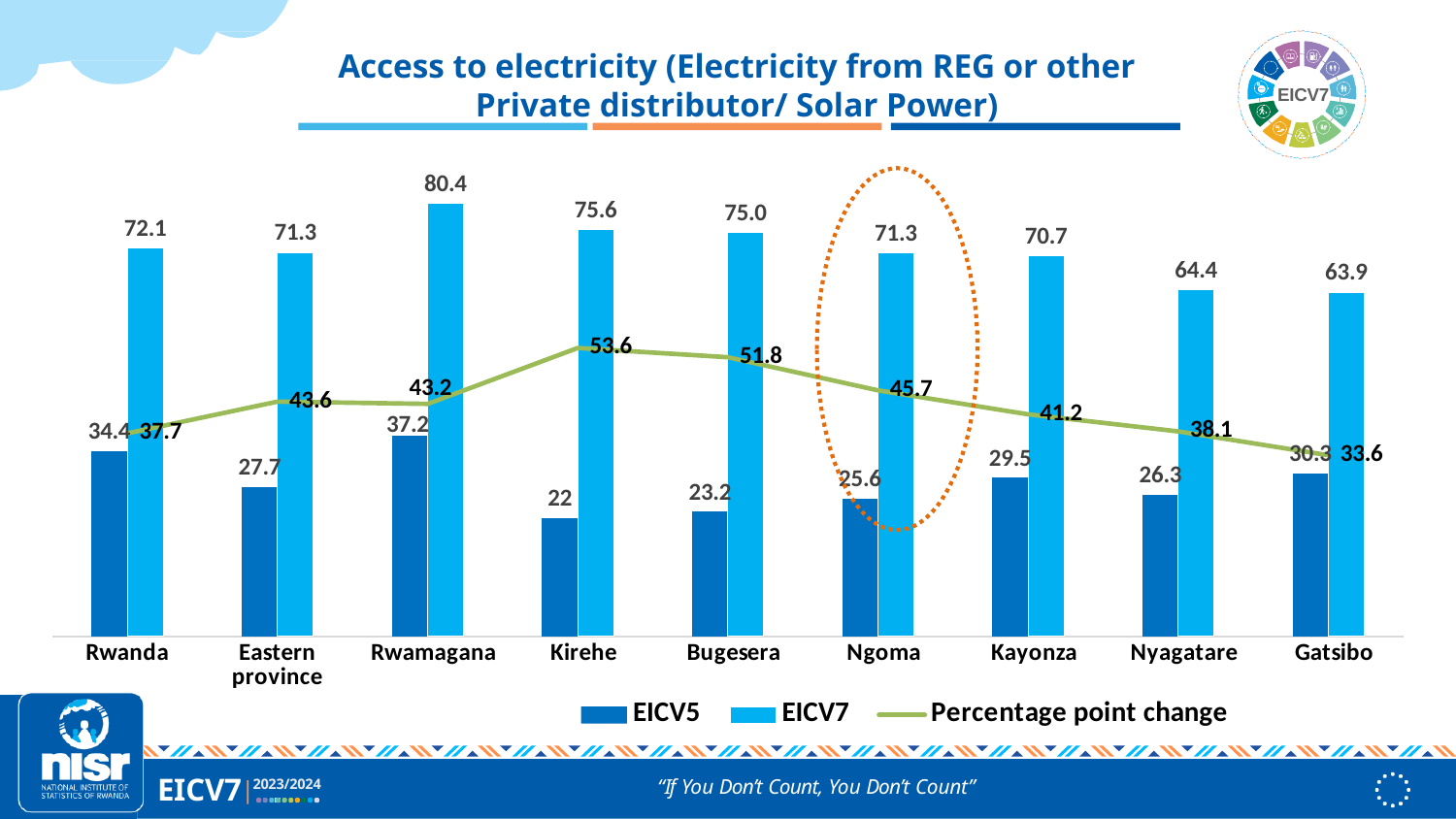
Which has the larger EICV7 value, Kirehe or Kayonza? Kirehe What is the EICV7 value for Rwamagana? 80.4 How many series does the legend list? 3 What is the difference between the EICV7 and EICV5 values for Rwamagana? 43.2 What is the EICV5 value for Ngoma? 25.6 How many categories are shown on the x axis? 9 What kind of chart is shown on the slide? Bar chart with a line Does the percentage point change line rise or fall from Ngoma to Gatsibo? Fall What is the EICV5 value for Kirehe? 22 Which category has the lowest percentage point change? Gatsibo What is the percentage point change for Kirehe? 53.6 Which category has the highest EICV7 value? Rwamagana